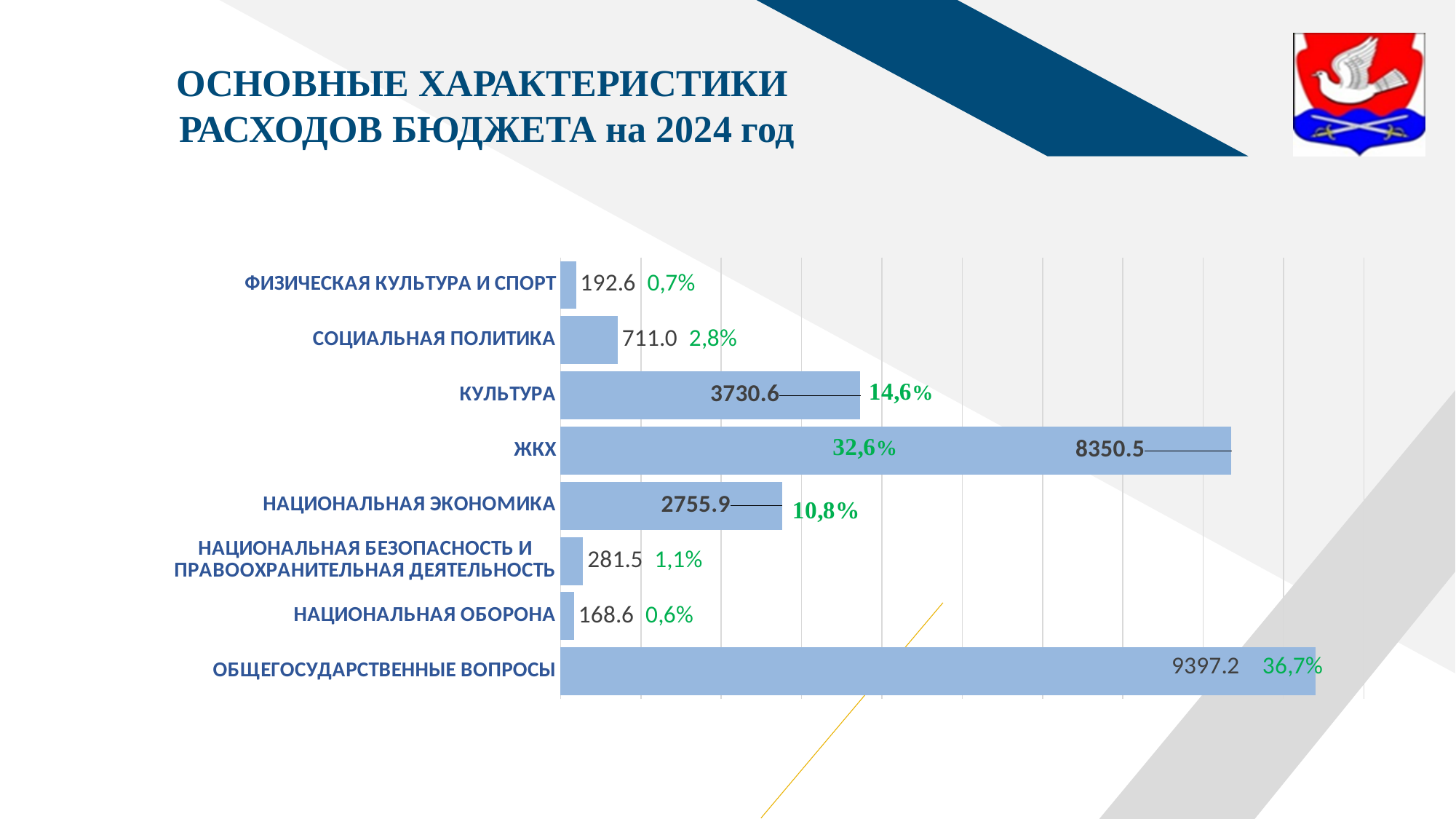
What is the difference between the values for ОБЩЕГОСУДАРСТВЕННЫЕ ВОПРОСЫ and ЖКХ? 1046.7 Which category has the highest value? ОБЩЕГОСУДАРСТВЕННЫЕ ВОПРОСЫ How many categories are shown in the chart? 8 Which category has the lowest value? НАЦИОНАЛЬНАЯ ОБОРОНА What is the value for ЖКХ? 8350.5 Which is larger, the value for СОЦИАЛЬНАЯ ПОЛИТИКА or the value for НАЦИОНАЛЬНАЯ БЕЗОПАСНОСТЬ И ПРАВООХРАНИТЕЛЬНАЯ ДЕЯТЕЛЬНОСТЬ? СОЦИАЛЬНАЯ ПОЛИТИКА What is the difference between the values for КУЛЬТУРА and НАЦИОНАЛЬНАЯ ЭКОНОМИКА? 974.7 What is the title of the slide? ОСНОВНЫЕ ХАРАКТЕРИСТИКИ РАСХОДОВ БЮДЖЕТА на 2024 год What is the value for КУЛЬТУРА? 3730.6 What percentage share is shown for ОБЩЕГОСУДАРСТВЕННЫЕ ВОПРОСЫ? 36,7% What kind of chart is shown on the slide? bar chart What is the value for НАЦИОНАЛЬНАЯ ОБОРОНА? 168.6